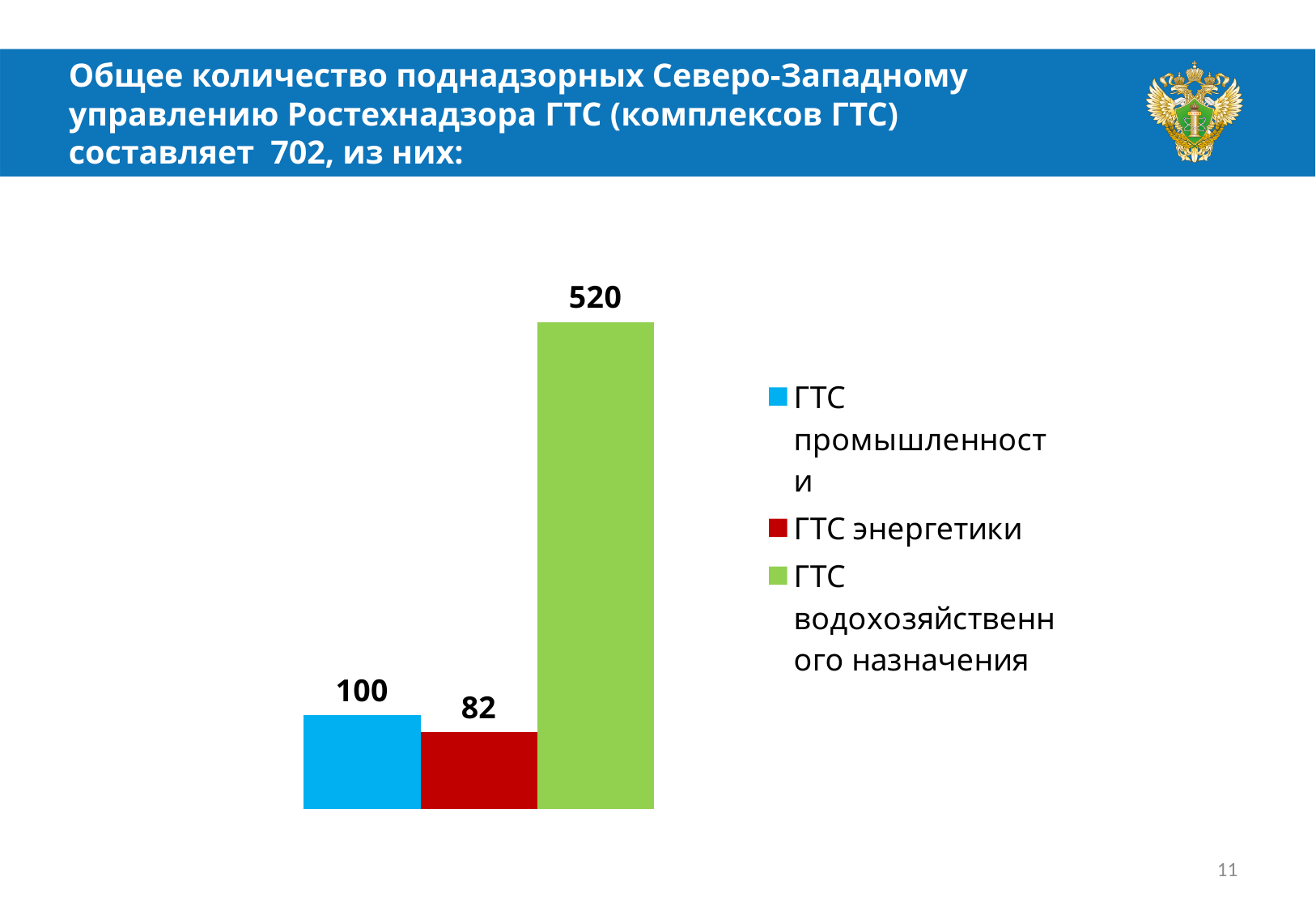
What is the difference between the values for ГТС промышленности and ГТС энергетики? 18 Which is larger, the value for ГТС промышленности or the value for ГТС энергетики? ГТС промышленности What is the value for ГТС промышленности? 100 How many bars are plotted on the chart? 3 What is the difference between the values for ГТС водохозяйственного назначения and ГТС промышленности? 420 What colour is the bar for ГТС энергетики? red Which series has the lowest value? ГТС энергетики Which series has the highest value? ГТС водохозяйственного назначения What is the value for ГТС водохозяйственного назначения? 520 What is the value for ГТС энергетики? 82 What kind of chart is shown on the slide? bar chart How many series does the legend list? 3